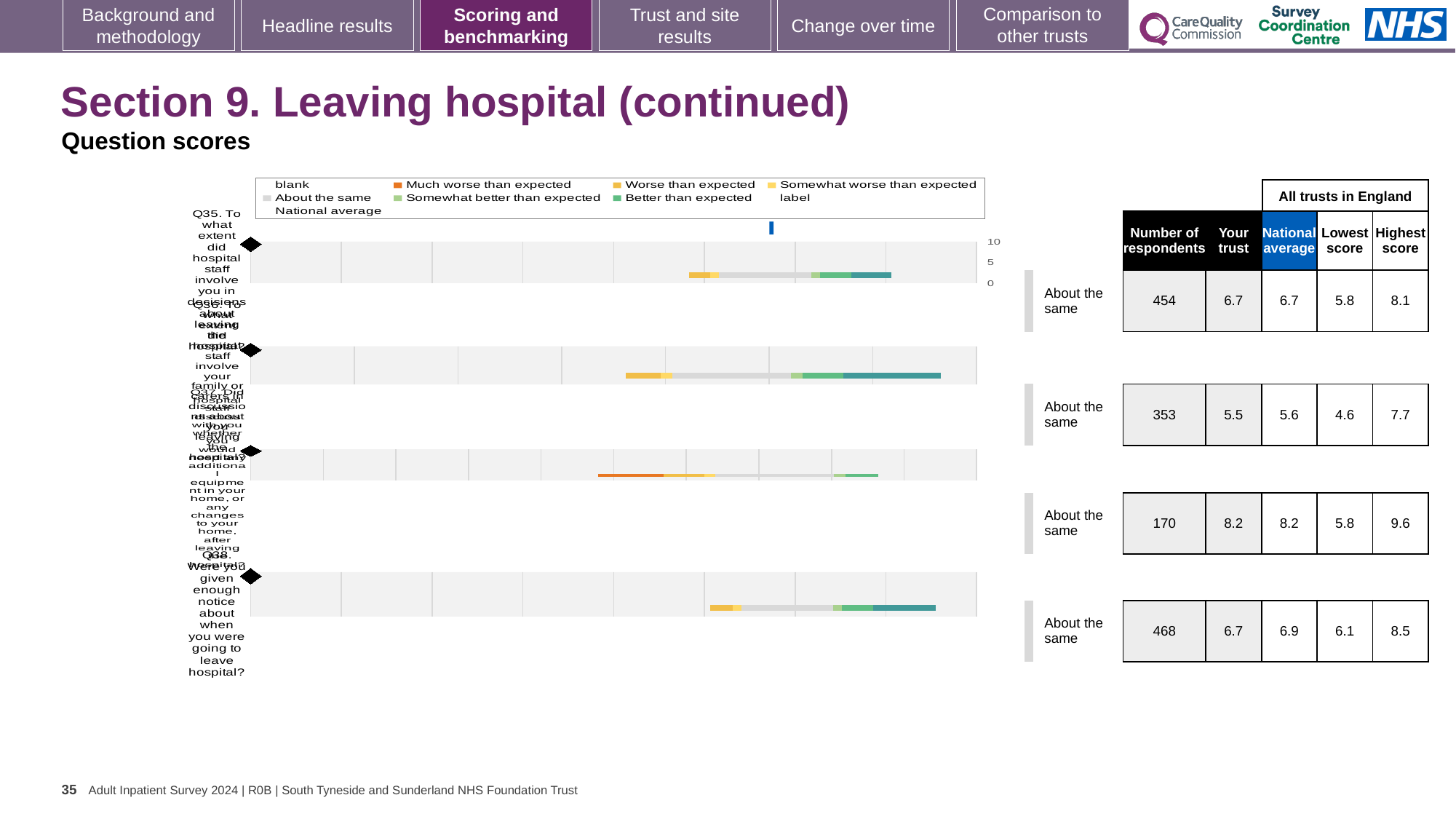
For the Q37 chart, what is the national average score? 8.2 For the Q36 chart, what is the 'Your trust' score? 5.5 For the Q36 chart, which is larger: the 'Your trust' score or the national average? National average For the Q35 chart, what is the number of respondents shown in the table? 454 How many questions (charts) are shown on this slide? 4 Which question has the highest 'Your trust' score? Q37 What benchmark category is shown next to the Q35 chart? About the same Which question has the lowest number of respondents? Q37 What kind of chart is used to show the question scores on this slide? bar chart For the Q38 chart, what is the difference between the highest score and the lowest score? 2.4 What is the title of the slide containing these charts? Section 9. Leaving hospital (continued) For the Q38 chart, what is the highest score among all trusts in England? 8.5